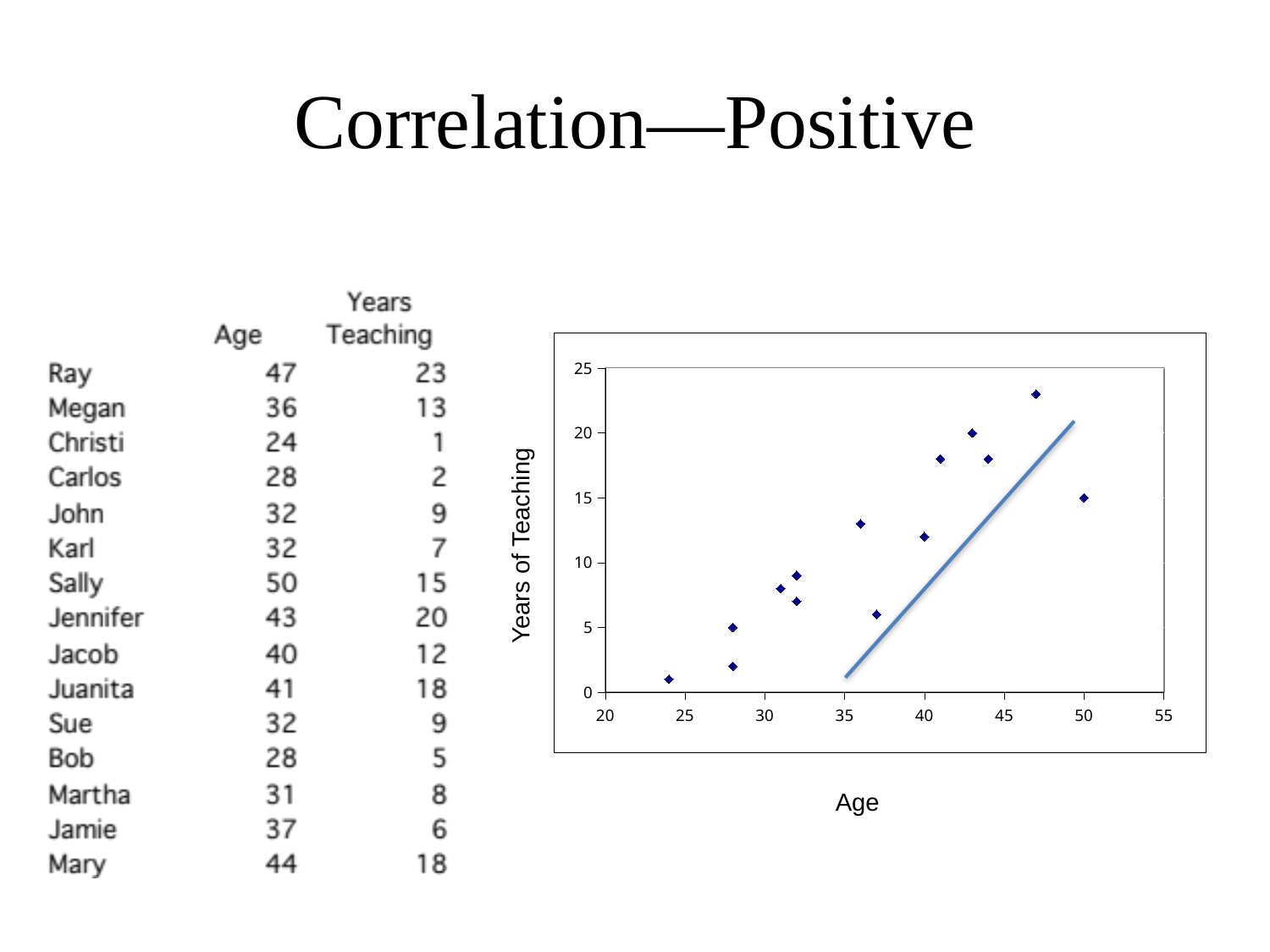
What is the label of the y axis of the chart? Years of Teaching Do the years of teaching generally rise or fall as age increases along the x axis? Rise According to the table, what is Sally's age? 50 What kind of chart is shown on the slide? Scatter plot Is the years-of-teaching value for the point at age 24 greater or less than 5? less What is the label of the x axis of the chart? Age According to the table, how many years of teaching does Ray have? 23 Which person in the table has the highest number of years teaching? Ray Is the years-of-teaching value for the point at age 50 greater or less than 10? greater What is the difference in years teaching between Jennifer and Jacob? 8 Which person in the table has the lowest number of years teaching? Christi Is the years-of-teaching value for the point at age 47 greater or less than 20? greater